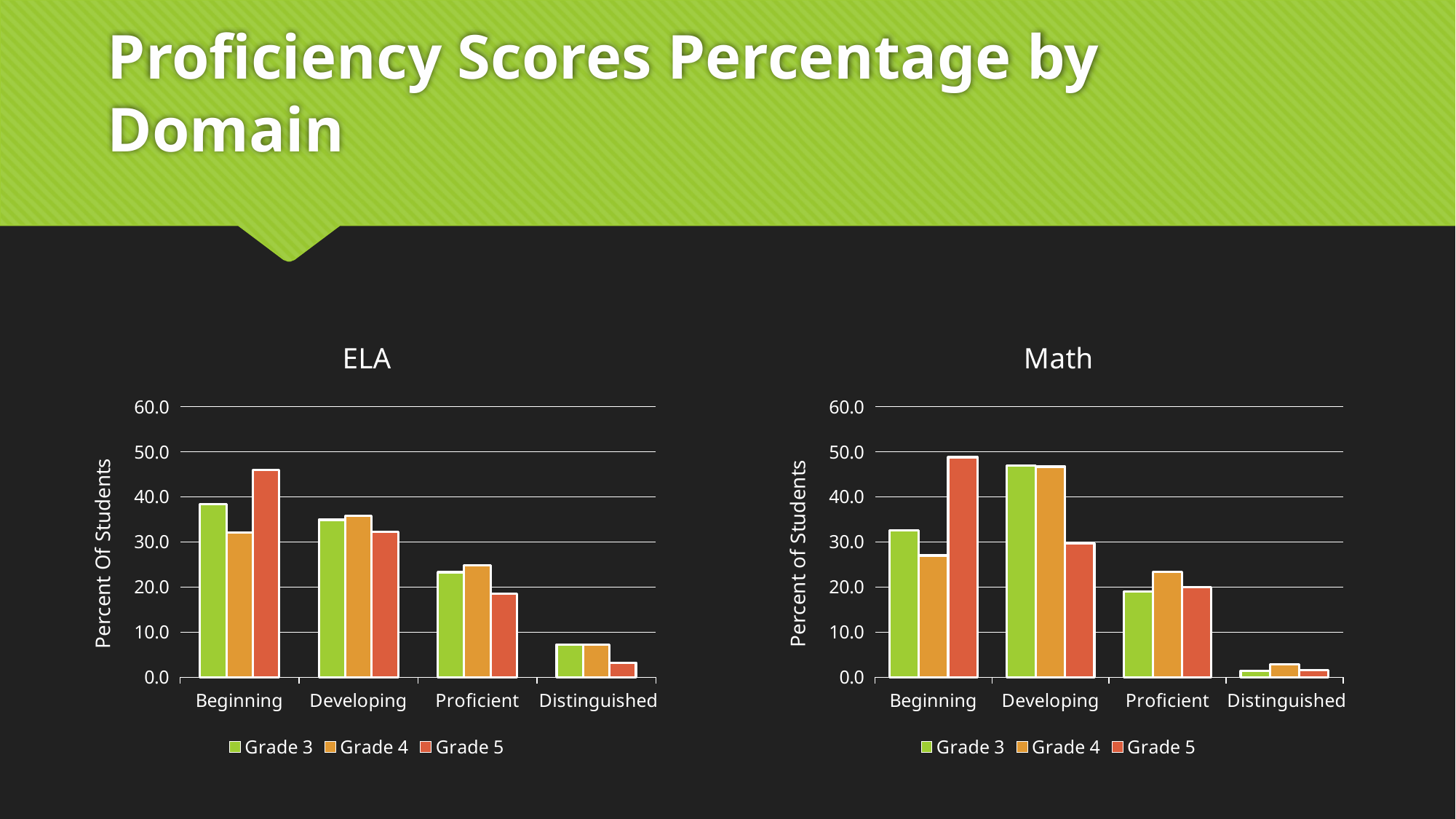
How many proficiency categories are shown on the x axis of the Math chart? 4 What is the y-axis title of the Math chart? Percent of Students How many series does the legend of the ELA chart list? 3 What kind of chart is the ELA chart? bar chart In the ELA chart, do the Grade 5 values rise or fall from Beginning to Distinguished? fall In the ELA chart, is the Grade 5 value for Distinguished greater or less than 10.0? less In the ELA chart, which category has the highest Grade 5 value? Beginning In the Math chart, is the Grade 4 value for Proficient greater or less than 20.0? greater In the Math chart, is the Grade 5 value for Beginning greater or less than 40.0? greater In the ELA chart, for the Proficient category, which is larger: the Grade 3 value or the Grade 5 value? Grade 3 In the Math chart, which grade has the lowest value in the Developing category? Grade 5